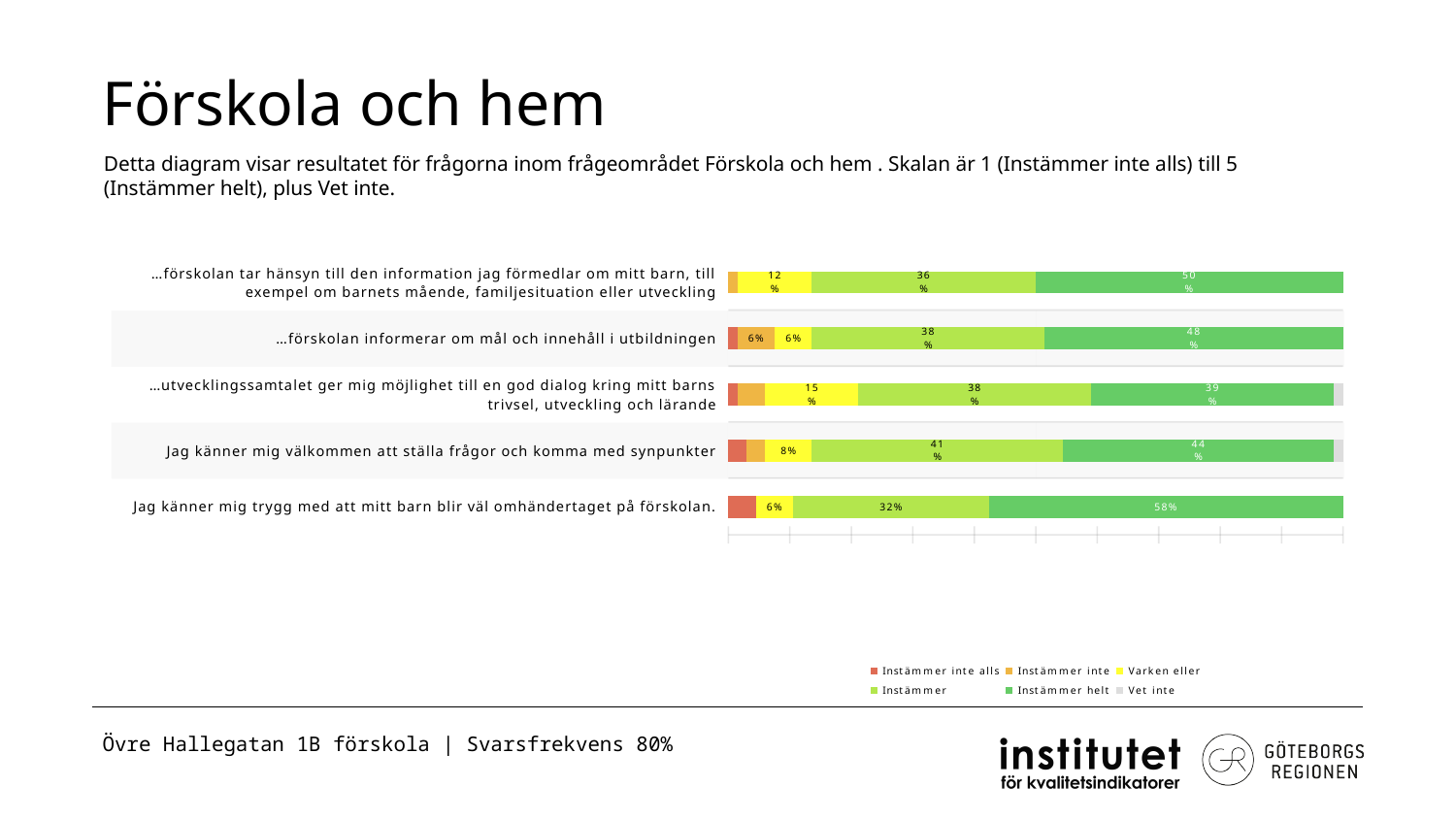
What is the 'Instämmer helt' value for 'Jag känner mig välkommen att ställa frågor och komma med synpunkter'? 44% What is the 'Instämmer' value for '…förskolan tar hänsyn till den information jag förmedlar om mitt barn, till exempel om barnets mående, familjesituation eller utveckling'? 36% How many statements (categories) are plotted in the chart? 5 How many series does the chart legend list? 6 Which legend entry is shown in yellow? Varken eller What kind of chart is shown on the slide? Stacked bar chart Which statement has the lowest 'Instämmer helt' share? …utvecklingssamtalet ger mig möjlighet till en god dialog kring mitt barns trivsel, utveckling och lärande Which is larger: the 'Instämmer' value for 'Jag känner mig välkommen att ställa frågor och komma med synpunkter' or for 'Jag känner mig trygg med att mitt barn blir väl omhändertaget på förskolan.'? Jag känner mig välkommen att ställa frågor och komma med synpunkter (41%) What is the 'Varken eller' value for '…utvecklingssamtalet ger mig möjlighet till en god dialog kring mitt barns trivsel, utveckling och lärande'? 15% What is the 'Instämmer helt' value for 'Jag känner mig trygg med att mitt barn blir väl omhändertaget på förskolan.'? 58% Which statement has the highest 'Instämmer helt' share? Jag känner mig trygg med att mitt barn blir väl omhändertaget på förskolan. What is the difference in 'Instämmer helt' between 'Jag känner mig trygg med att mitt barn blir väl omhändertaget på förskolan.' (58%) and '…förskolan tar hänsyn till den information jag förmedlar om mitt barn…' (50%)? 8 percentage points